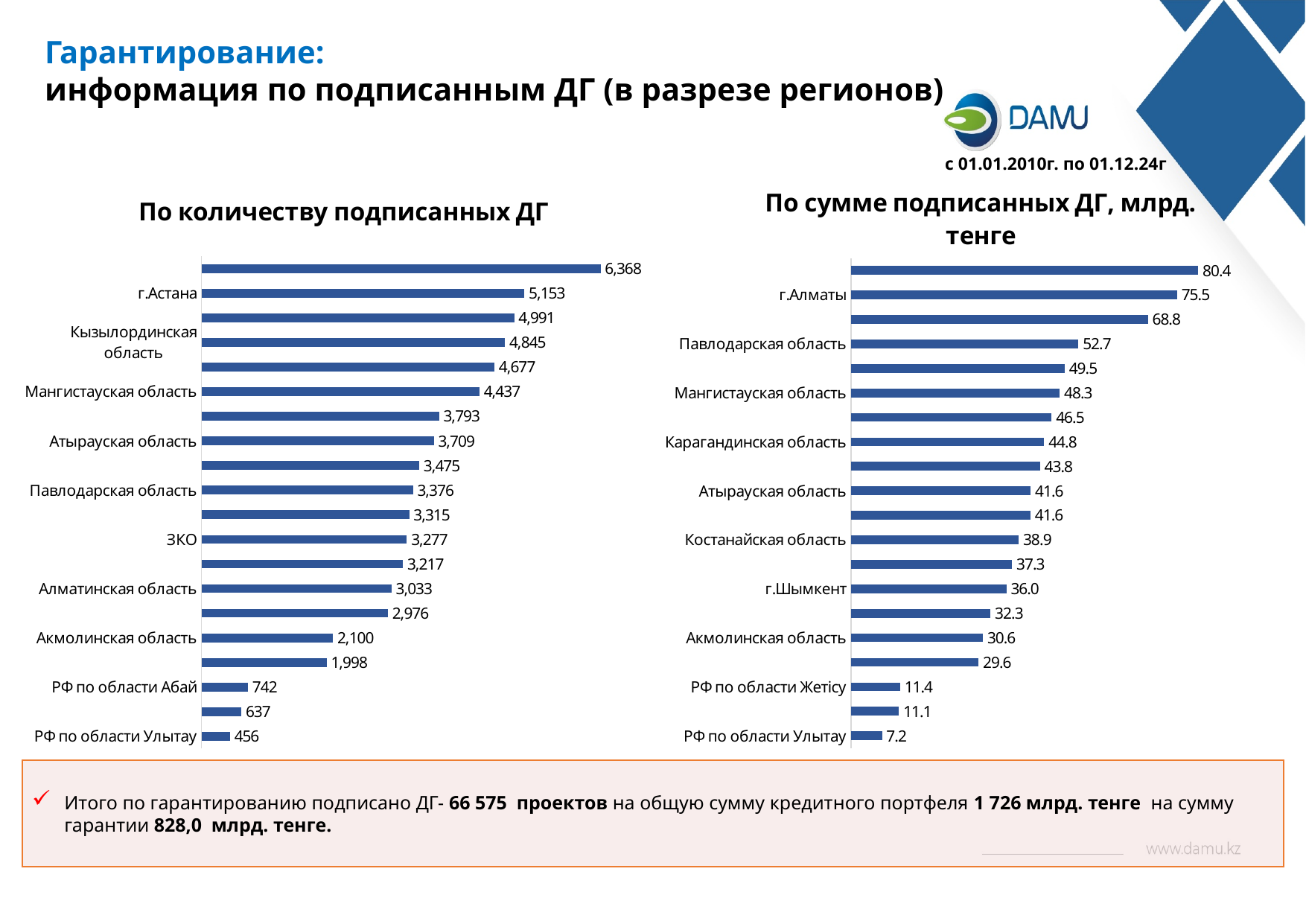
What type of chart is 'По количеству подписанных ДГ'? Bar chart On the chart 'По сумме подписанных ДГ, млрд. тенге', what is the value for г.Шымкент? 36.0 On the chart 'По количеству подписанных ДГ', what is the value for Мангистауская область? 4,437 On the chart 'По количеству подписанных ДГ', which labeled region has the lowest value? РФ по области Улытау On the chart 'По количеству подписанных ДГ', which is larger: Павлодарская область or ЗКО? Павлодарская область On the chart 'По количеству подписанных ДГ', what is the value for г.Астана? 5,153 On the chart 'По количеству подписанных ДГ', what is the difference between г.Астана and Кызылординская область? 308 How many bars are shown on the chart 'По сумме подписанных ДГ, млрд. тенге'? 20 On the chart 'По сумме подписанных ДГ, млрд. тенге', what is the difference between Павлодарская область and Мангистауская область? 4.4 On the chart 'По сумме подписанных ДГ, млрд. тенге', what is the value for г.Алматы? 75.5 On the chart 'По количеству подписанных ДГ', what is the value for РФ по области Абай? 742 On the chart 'По сумме подписанных ДГ, млрд. тенге', what is the value for РФ по области Улытау? 7.2